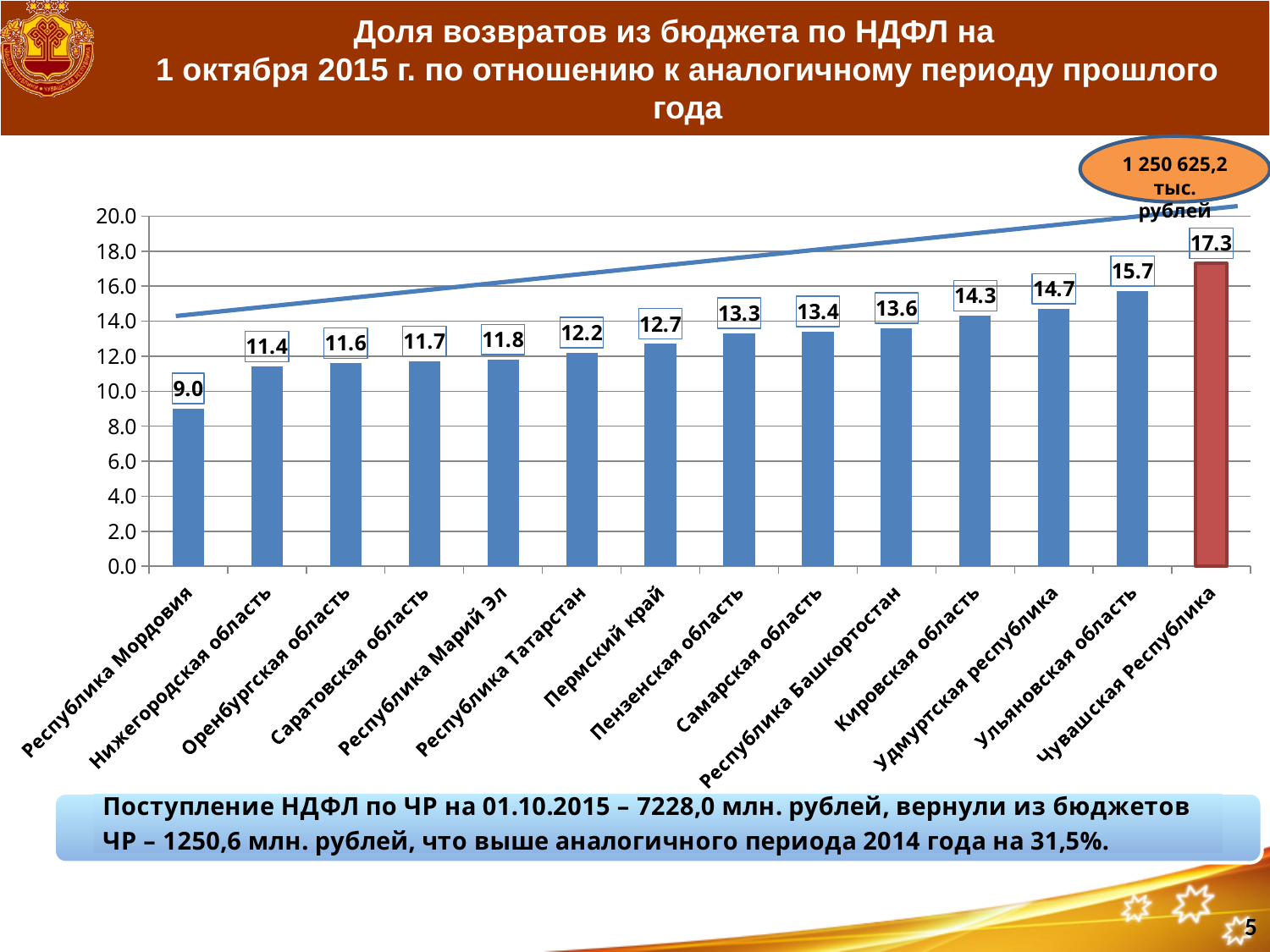
What is the difference between the values for Республика Башкортостан and Республика Мордовия? 4.6 What is the value for Республика Мордовия? 9.0 Which is larger, the value for Удмуртская республика or the value for Самарская область? Удмуртская республика Do the values rise or fall from left to right along the x axis? Rise Which region has the highest value? Чувашская Республика How many regions are shown on the chart? 14 What is the value for Кировская область? 14.3 What is the value for Чувашская Республика? 17.3 What kind of chart is shown on the slide? Bar chart What is the difference between the values for Чувашская Республика and Ульяновская область? 1.6 Which region has the lowest value? Республика Мордовия What is the value for Пермский край? 12.7